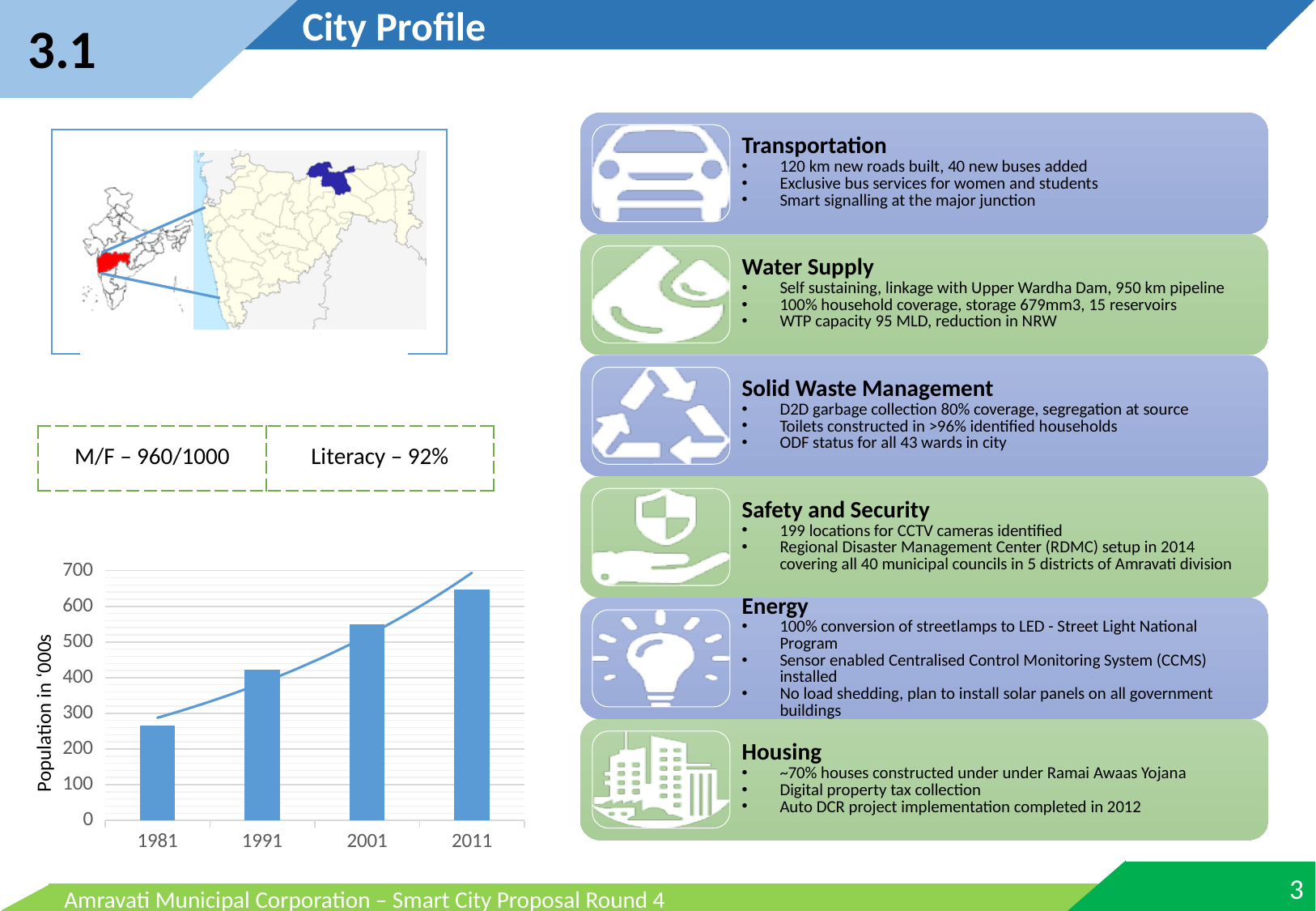
What is the highest value shown on the vertical axis of the population chart? 700 Which year has the lowest population on the chart? 1981 How many years are plotted on the population chart? 4 Is the population value for 2011 greater or less than 600? greater Is the population value for 2001 greater or less than 500? greater Is the population value for 1991 greater or less than 400? greater Which year has the larger population, 1991 or 2001? 2001 What is the label on the vertical axis of the population chart? Population in '000s Which year has the highest population on the chart? 2011 What kind of chart is shown at the bottom left of the slide? bar chart Do the population values rise or fall from 1981 to 2011? rise